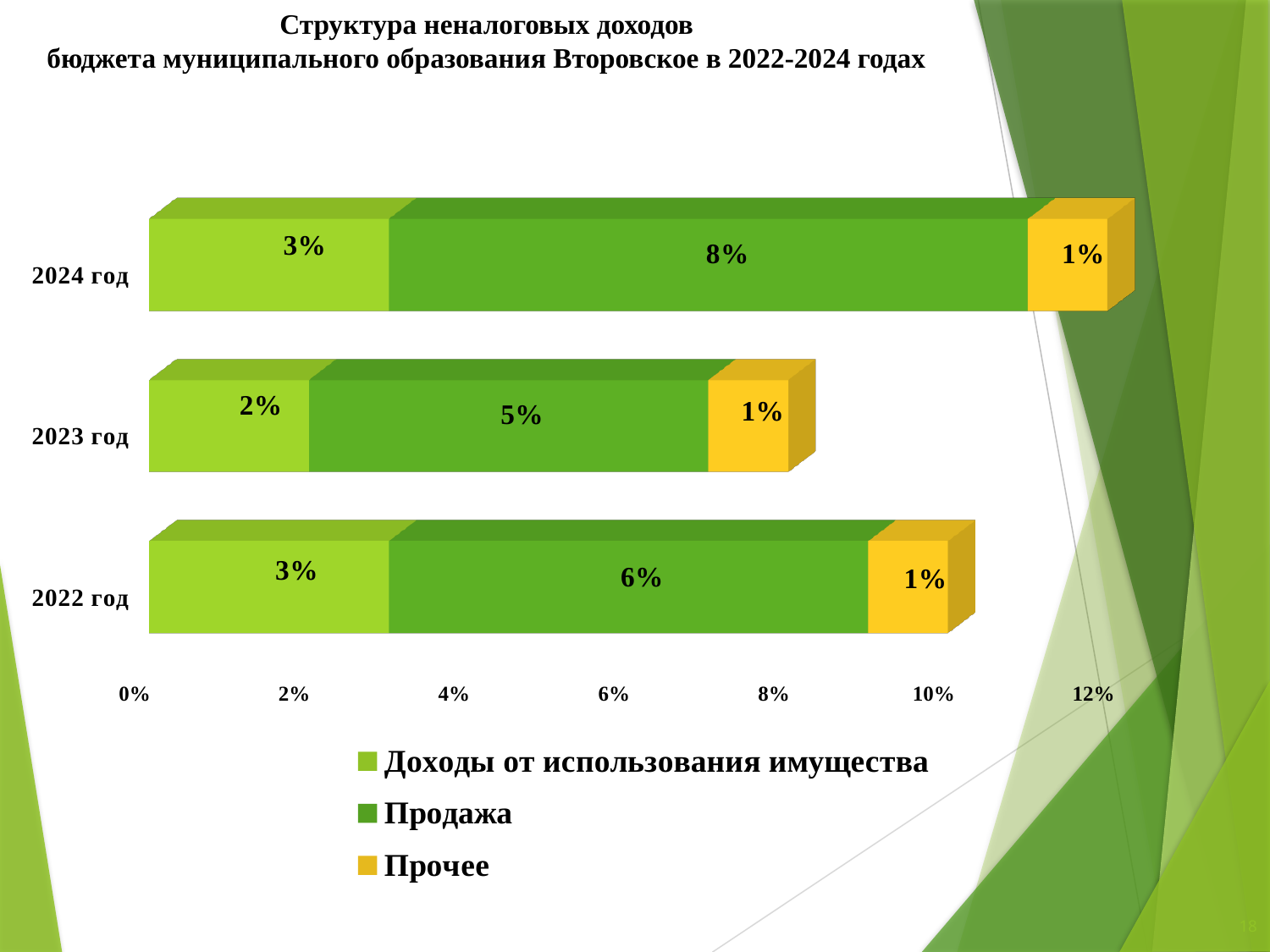
How many years (categories) are shown on the chart? 3 Which series is shown in yellow in the legend? Прочее In which year is the value for Доходы от использования имущества the lowest? 2023 год What is the value for Прочее in 2022 год? 1% What kind of chart is shown on the slide? Stacked bar chart What is the value for Продажа in 2022 год? 6% How many series does the legend list? 3 What is the difference between the Продажа values for 2024 год and 2023 год? 3% Which is larger: the Продажа value for 2022 год or for 2023 год? 2022 год In which year is the value for Продажа the highest? 2024 год What is the value for Доходы от использования имущества in 2023 год? 2% What is the value for Продажа in 2024 год? 8%